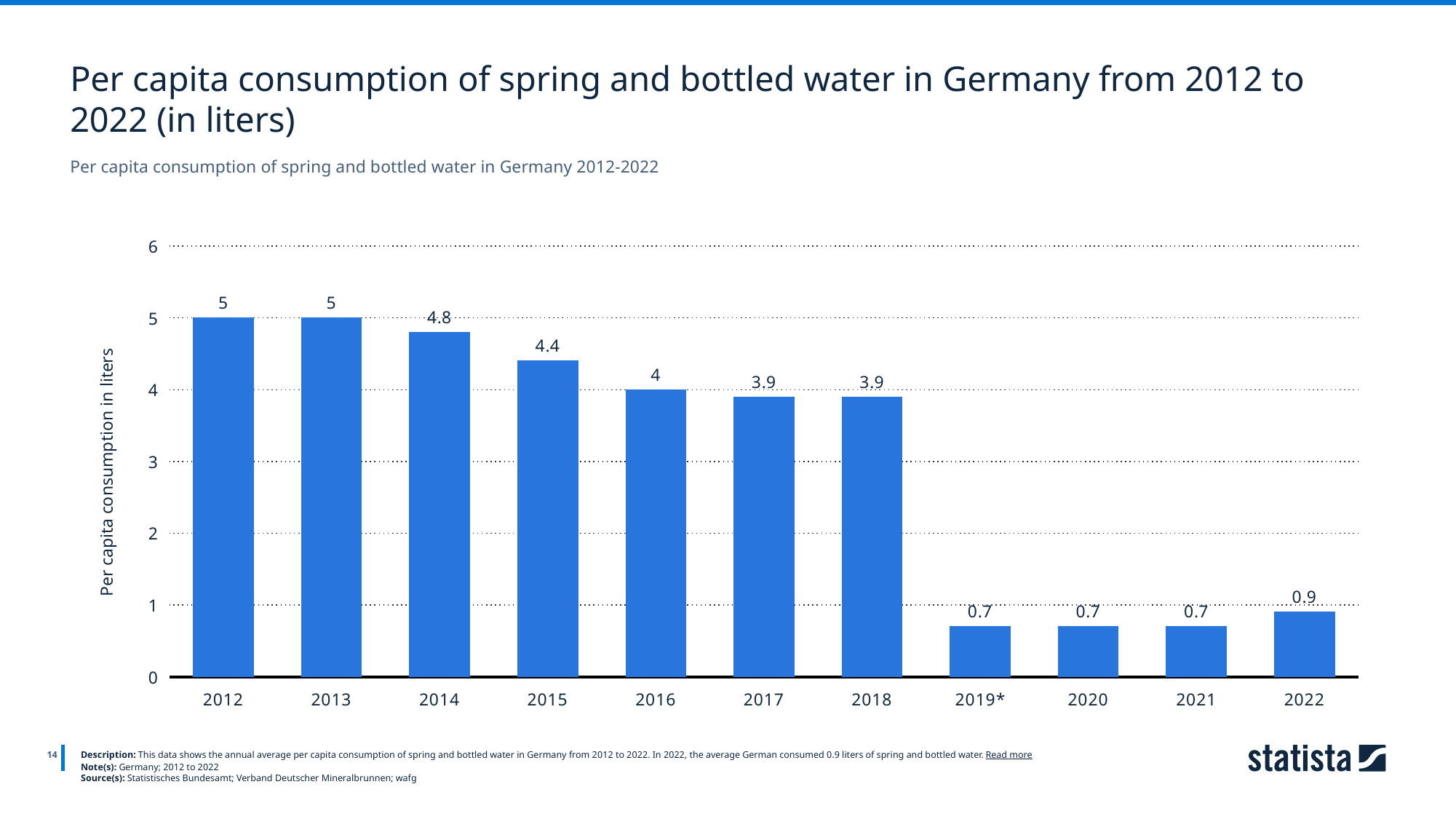
What was the per capita consumption of spring and bottled water in Germany in 2014? 4.8 Which year has the lowest value that is not tied with another year? 2022 Which is larger, the value for 2014 or the value for 2018? 2014 What is the difference between the values for 2015 and 2016? 0.4 How many years are shown on the x axis? 11 Is the value for 2020 greater or less than 1? less What was the per capita consumption in 2019*? 0.7 What is the difference between the values for 2012 and 2022? 4.1 Is the value for 2015 greater or less than 4? greater What value is shown for 2022? 0.9 Do the values generally rise or fall from 2012 to 2021? fall What kind of chart is shown on the slide? bar chart